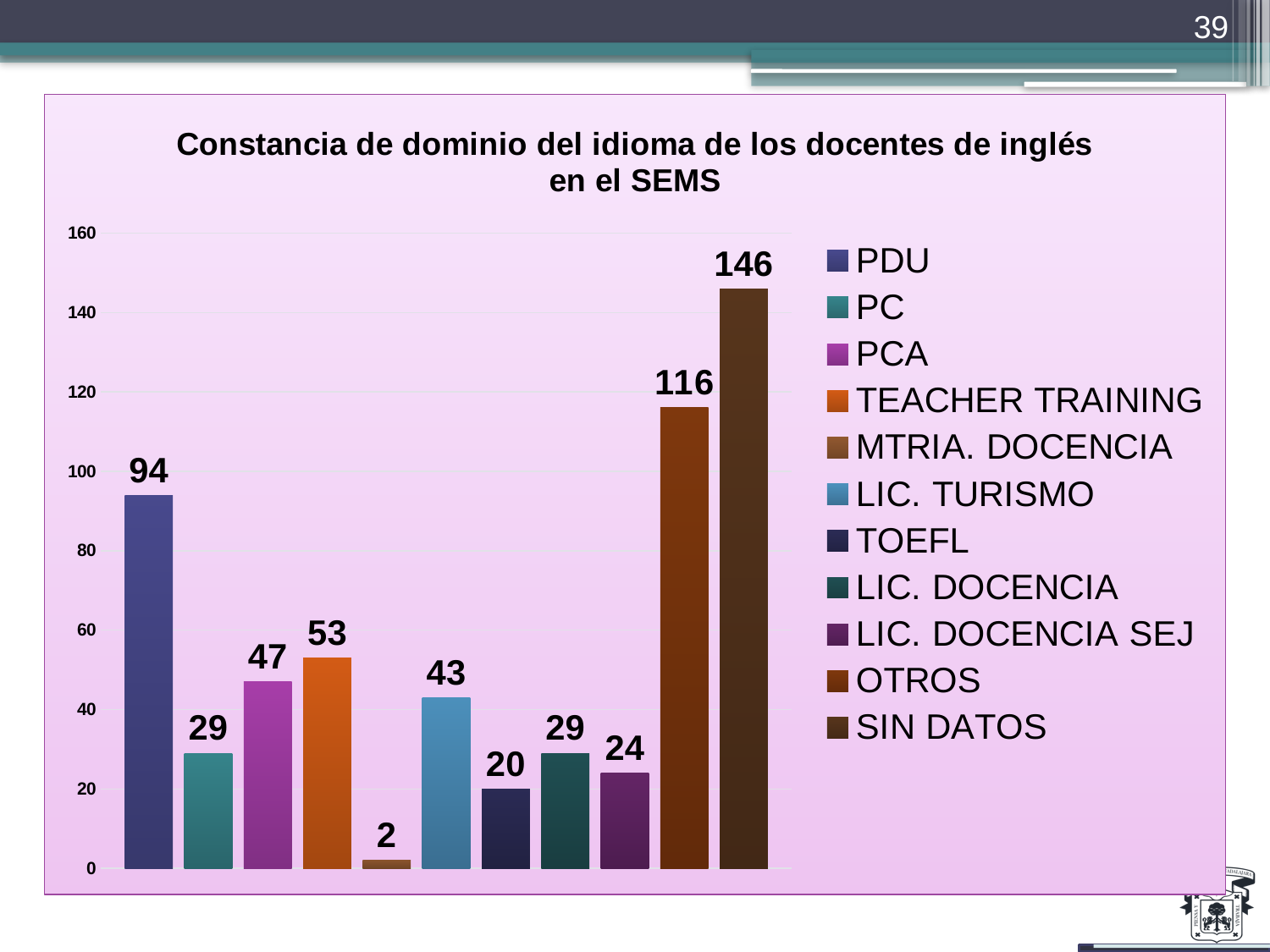
What is the value for PDU? 94 Which category has the highest value? SIN DATOS How many bars are plotted in the chart? 11 What kind of chart is shown on the slide? Bar chart What is the value for TEACHER TRAINING? 53 Which is larger, the value for PCA or the value for TOEFL? PCA Which category has the lowest value? MTRIA. DOCENCIA What is the value for LIC. TURISMO? 43 What is the value for SIN DATOS? 146 How many entries does the legend list? 11 What is the difference between the values for SIN DATOS and OTROS? 30 Is the value for OTROS greater or less than 100? greater